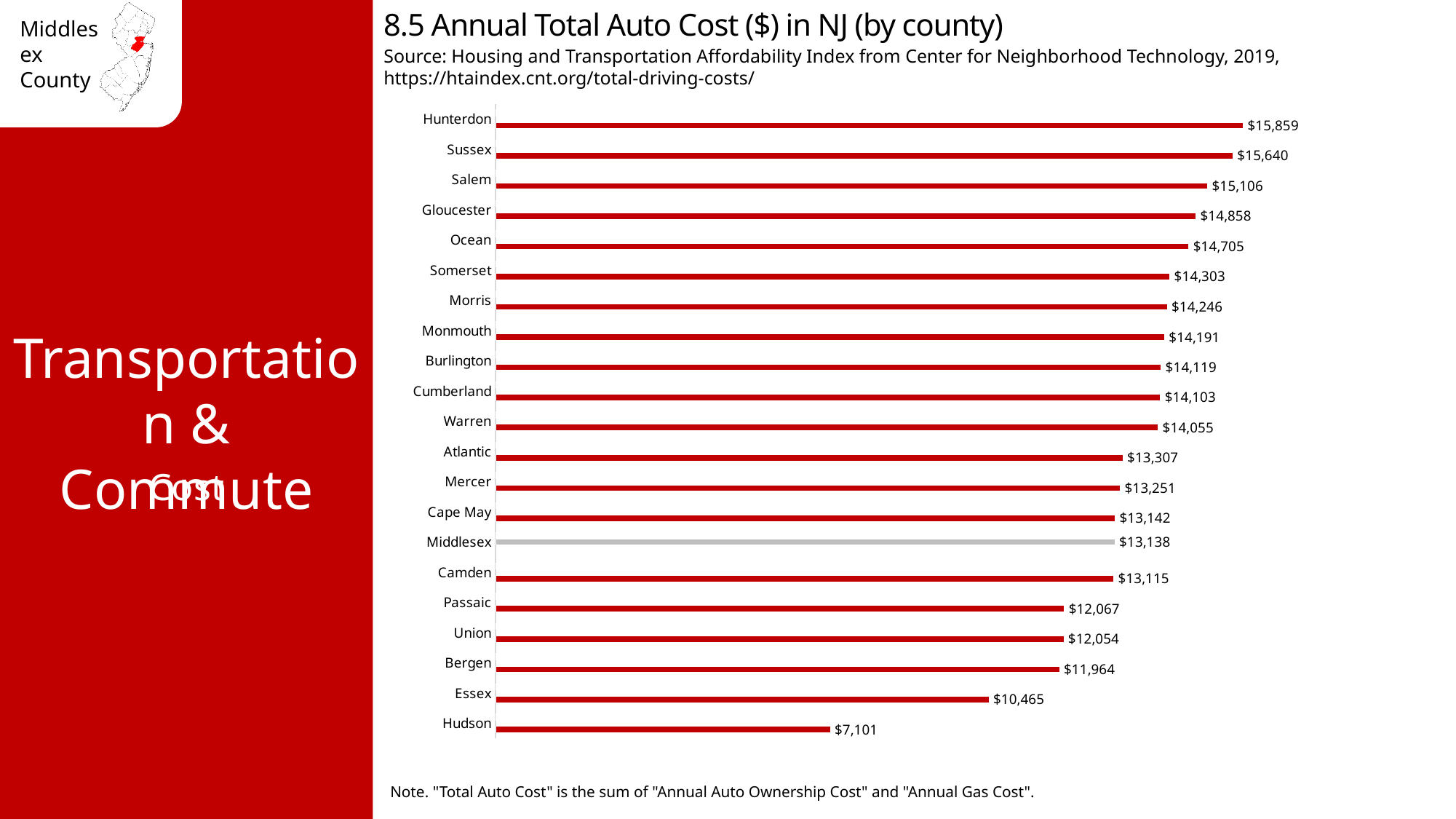
How many counties are shown in the chart? 21 What is the annual total auto cost for Ocean County? $14,705 What is the difference in annual total auto cost between Cape May and Middlesex? $4 Which county has the highest annual total auto cost? Hunterdon What is the difference in annual total auto cost between Hunterdon and Hudson? $8,758 Which county has the lowest annual total auto cost? Hudson Which county has a higher annual total auto cost, Essex or Bergen? Bergen Which county has a higher annual total auto cost, Sussex or Salem? Sussex What is the annual total auto cost for Middlesex County? $13,138 Which county's bar is shown in grey instead of red? Middlesex What kind of chart is used to show annual total auto cost by county? Bar chart What is the annual total auto cost for Hudson County? $7,101